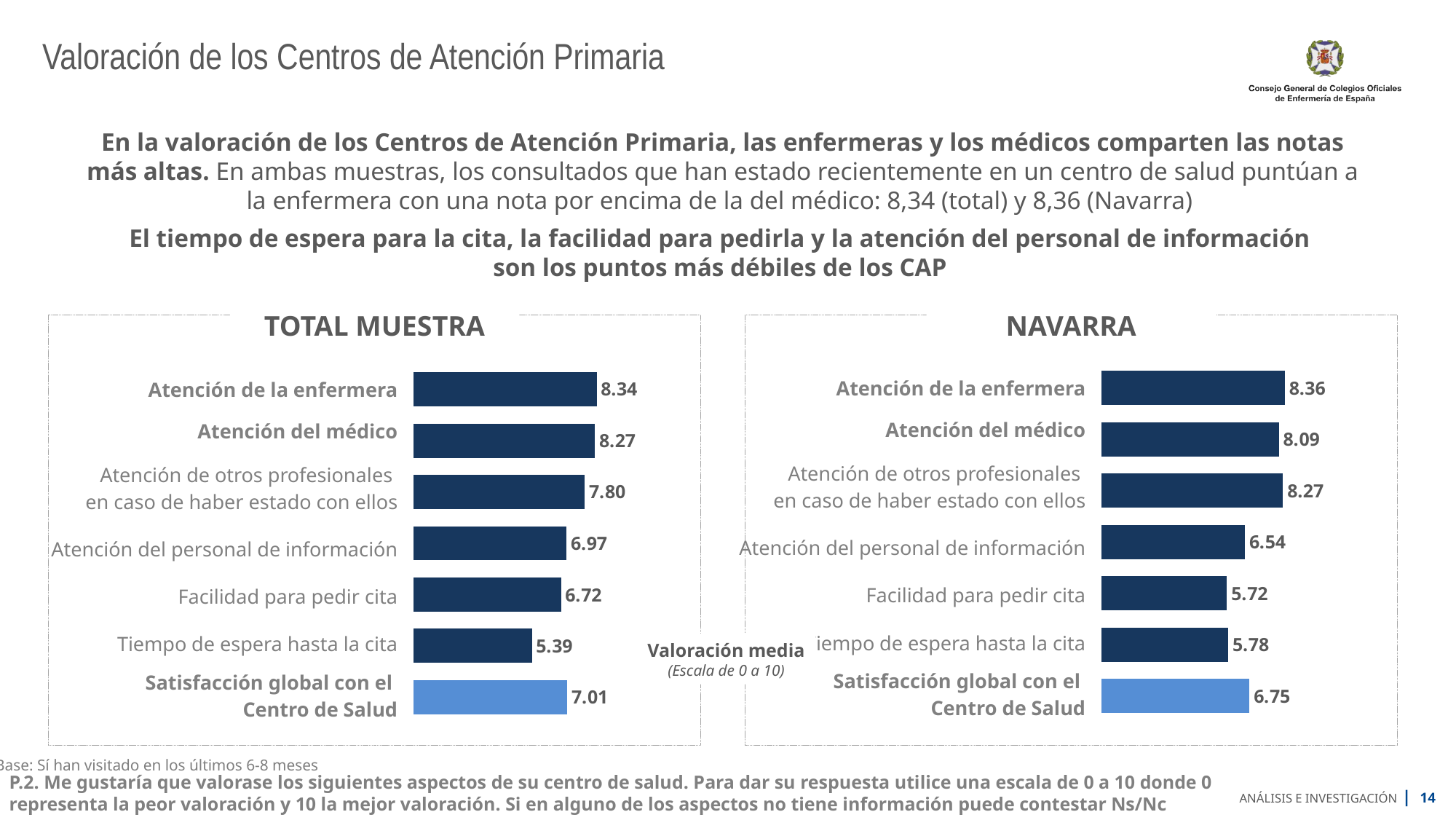
In the TOTAL MUESTRA chart, which is larger: Atención del personal de información or Facilidad para pedir cita? Atención del personal de información How many categories does the NAVARRA chart show? 7 In the NAVARRA chart, which category has the lowest value? Facilidad para pedir cita In the TOTAL MUESTRA chart, what is the difference between Atención de la enfermera and Tiempo de espera hasta la cita? 2.95 What kind of chart is the TOTAL MUESTRA chart? Bar chart In the TOTAL MUESTRA chart, what is the value for Atención de la enfermera? 8.34 In the NAVARRA chart, what is the value for Atención del médico? 8.09 In the TOTAL MUESTRA chart, which category is shown in a lighter blue colour than the others? Satisfacción global con el Centro de Salud In the NAVARRA chart, what is the difference between Atención de la enfermera and Atención del médico? 0.27 In the NAVARRA chart, which category has the highest value? Atención de la enfermera In the NAVARRA chart, what is the value for Satisfacción global con el Centro de Salud? 6.75 In the TOTAL MUESTRA chart, which category has the lowest value? Tiempo de espera hasta la cita